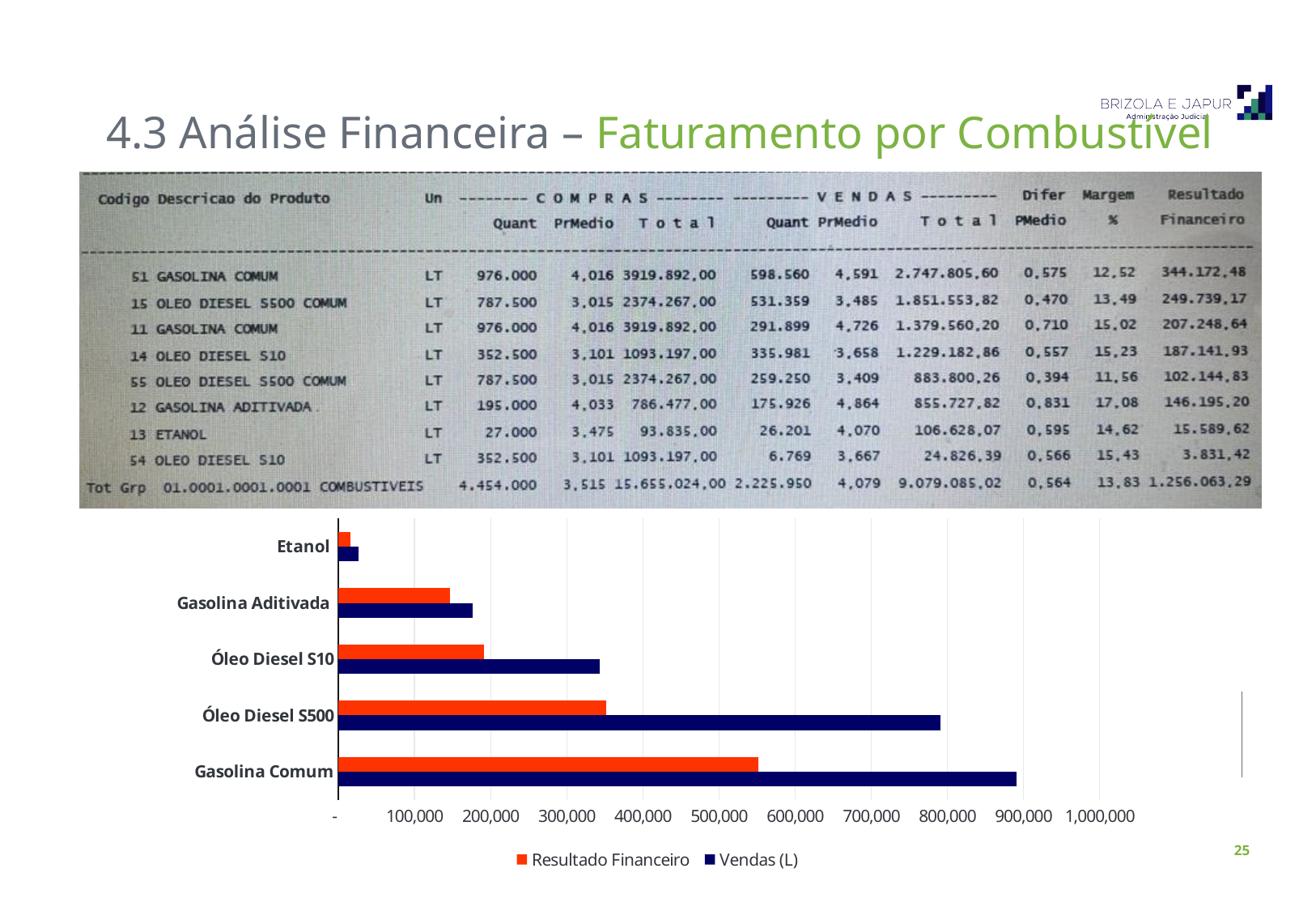
How many fuel categories are plotted in the bar chart? 5 What kind of chart is shown on the slide? bar chart Is the Resultado Financeiro value for Gasolina Comum greater or less than 500,000? greater Is the Vendas (L) value for Etanol greater or less than 100,000? less Which has a larger Vendas (L) value: Gasolina Comum or Óleo Diesel S500? Gasolina Comum Which series is shown in dark blue in the bar chart? Vendas (L) Which category has the highest Resultado Financeiro value in the bar chart? Gasolina Comum Which category has the highest Vendas (L) value in the bar chart? Gasolina Comum How many series does the chart legend list? 2 Is the Vendas (L) value for Óleo Diesel S10 greater or less than 300,000? greater Which category has the lowest Resultado Financeiro value in the bar chart? Etanol